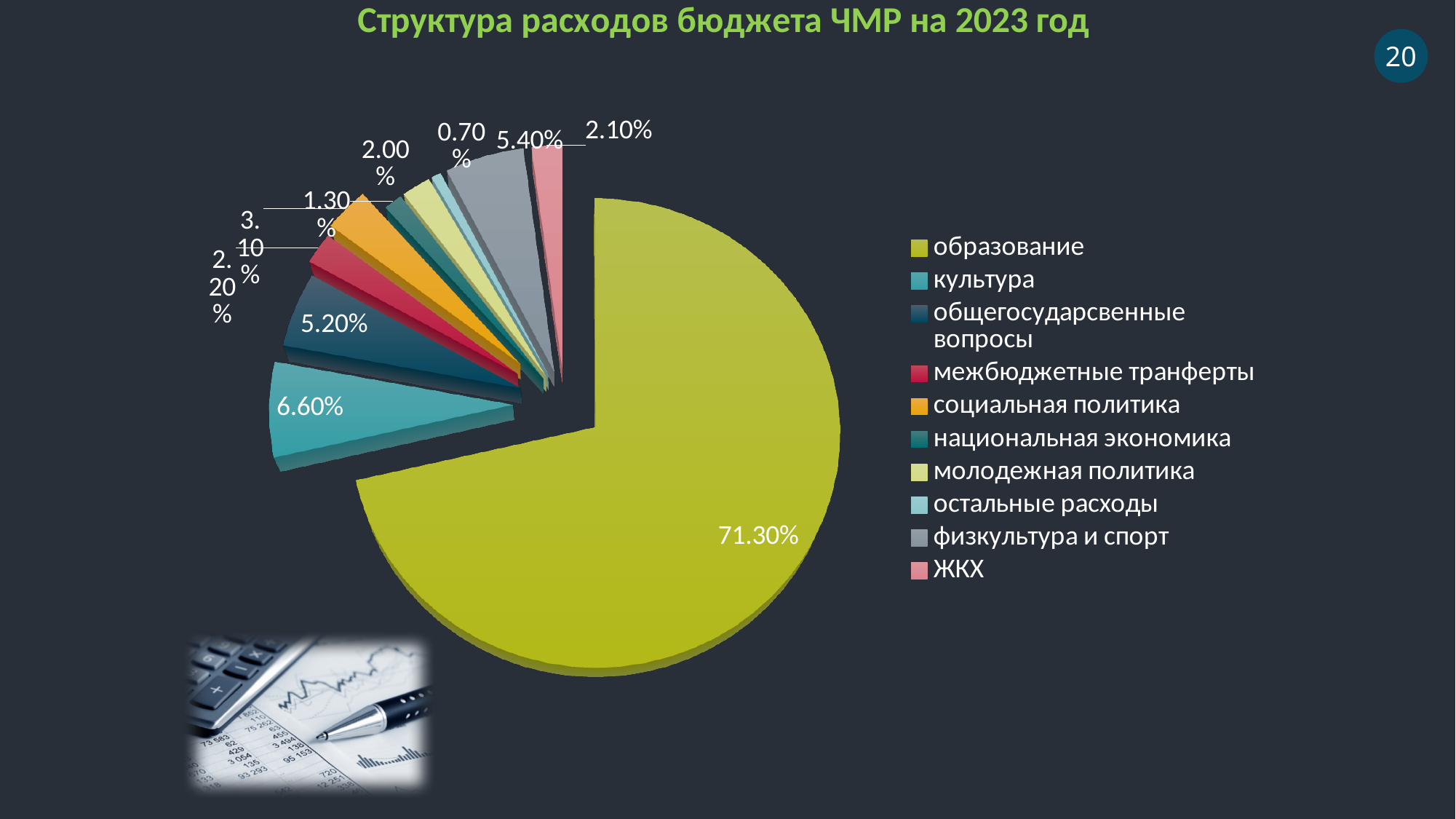
What share of the budget expenditure goes to образование? 71.30% How many categories does the legend list? 10 What is the title of the chart? Структура расходов бюджета ЧМР на 2023 год What share of the budget expenditure goes to общегосударсвенные вопросы? 5.20% Which category has the largest share of the budget expenditure? образование What kind of chart is shown on the slide? pie chart What share of the budget expenditure goes to культура? 6.60% Which has a larger share: культура or общегосударсвенные вопросы? культура Is the share for образование greater or less than 50%? greater Which category has the smallest share of the budget expenditure? остальные расходы What share of the budget expenditure goes to ЖКХ? 2.10% What share of the budget expenditure goes to физкультура и спорт? 5.40%